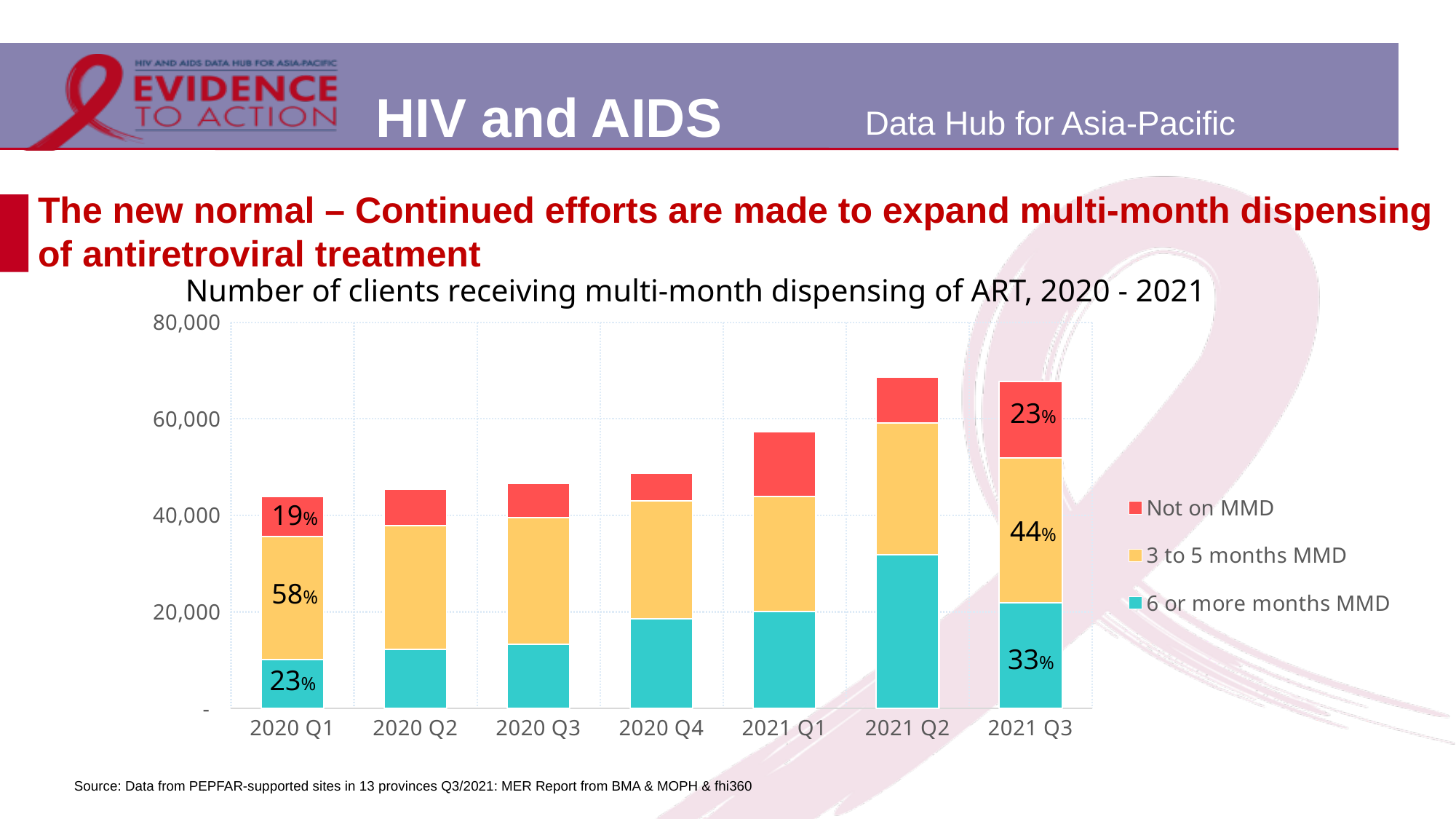
What percentage of clients in 2020 Q1 were on 3 to 5 months MMD? 58% How many series does the legend list? 3 What is the title of the chart? Number of clients receiving multi-month dispensing of ART, 2020 - 2021 What type of chart is shown on the slide? bar chart Which quarter has the lowest total number of clients? 2020 Q1 Which quarter has a larger total number of clients, 2020 Q4 or 2021 Q1? 2021 Q1 What percentage of clients in 2021 Q3 were not on MMD? 23% How many quarters are shown on the x axis? 7 What percentage of clients in 2021 Q3 were on 6 or more months MMD? 33% Does the number of clients on 6 or more months MMD rise or fall from 2020 Q1 to 2021 Q3? rise What percentage of clients in 2020 Q1 were not on MMD? 19% Is the total number of clients in 2021 Q2 greater or less than 60,000? greater